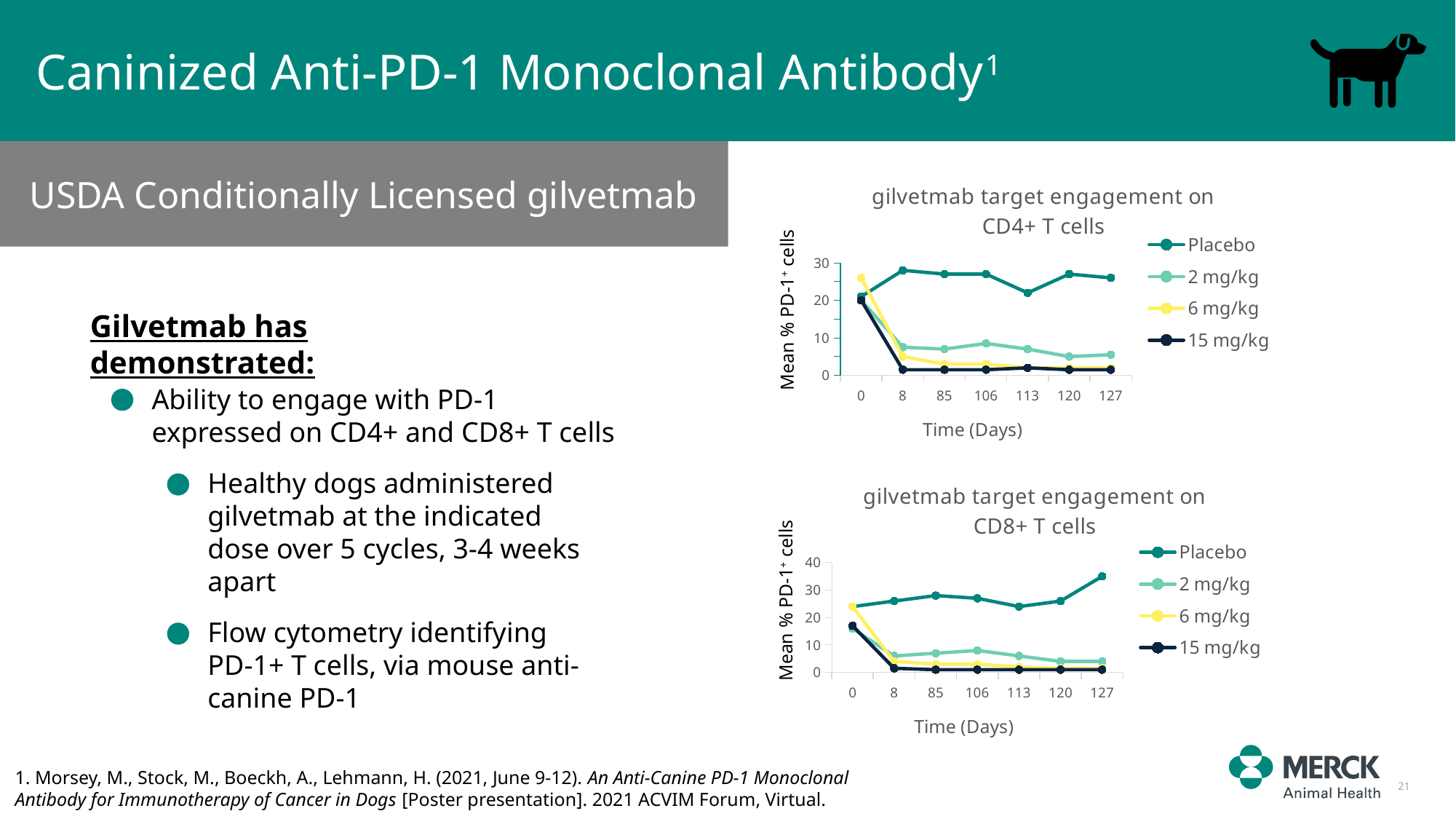
In the 'gilvetmab target engagement on CD8+ T cells' chart, which is larger at day 106: 2 mg/kg or 15 mg/kg? 2 mg/kg In the 'gilvetmab target engagement on CD8+ T cells' chart, does the Placebo series rise or fall from day 120 to day 127? rise In the 'gilvetmab target engagement on CD8+ T cells' chart, is the Placebo value at day 127 greater or less than 30? greater In the 'gilvetmab target engagement on CD4+ T cells' chart, is the 15 mg/kg value at day 127 greater or less than 10? less In the 'gilvetmab target engagement on CD4+ T cells' chart, which series has the highest value at day 127? Placebo In the 'gilvetmab target engagement on CD4+ T cells' chart, is the Placebo value at day 8 greater or less than 20? greater What kind of chart is the 'gilvetmab target engagement on CD4+ T cells' chart? line chart In the 'gilvetmab target engagement on CD4+ T cells' chart, which is larger at day 85: Placebo or 2 mg/kg? Placebo How many series does the legend of the 'gilvetmab target engagement on CD8+ T cells' chart list? 4 What is the x-axis label of the 'gilvetmab target engagement on CD8+ T cells' chart? Time (Days) How many time points are plotted along the x axis of the 'gilvetmab target engagement on CD4+ T cells' chart? 7 In the 'gilvetmab target engagement on CD4+ T cells' chart, does the 15 mg/kg series rise or fall from day 0 to day 8? fall